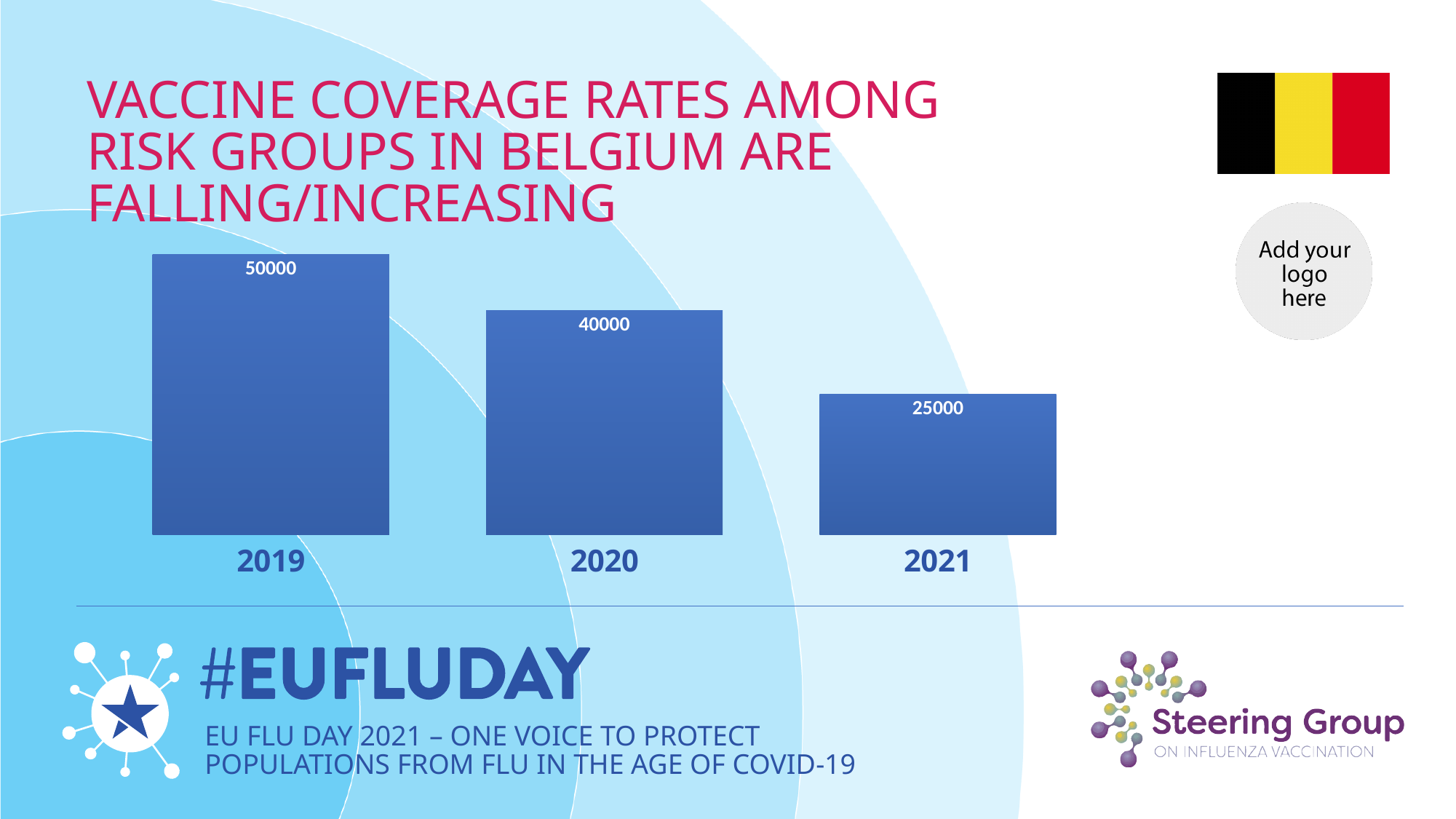
What is the value shown for 2019? 50000 What is the difference between the values for 2019 and 2021? 25000 What kind of chart is shown on the slide? Bar chart Which year has the highest value? 2019 Which year has the lowest value? 2021 What is the value shown for 2020? 40000 What is the value shown for 2021? 25000 How many years are shown on the chart? 3 What is the difference between the values for 2020 and 2021? 15000 Which is larger, the value for 2020 or the value for 2021? 2020 What is the total of the values for 2019, 2020 and 2021? 115000 Do the values rise or fall from 2019 to 2021? Fall